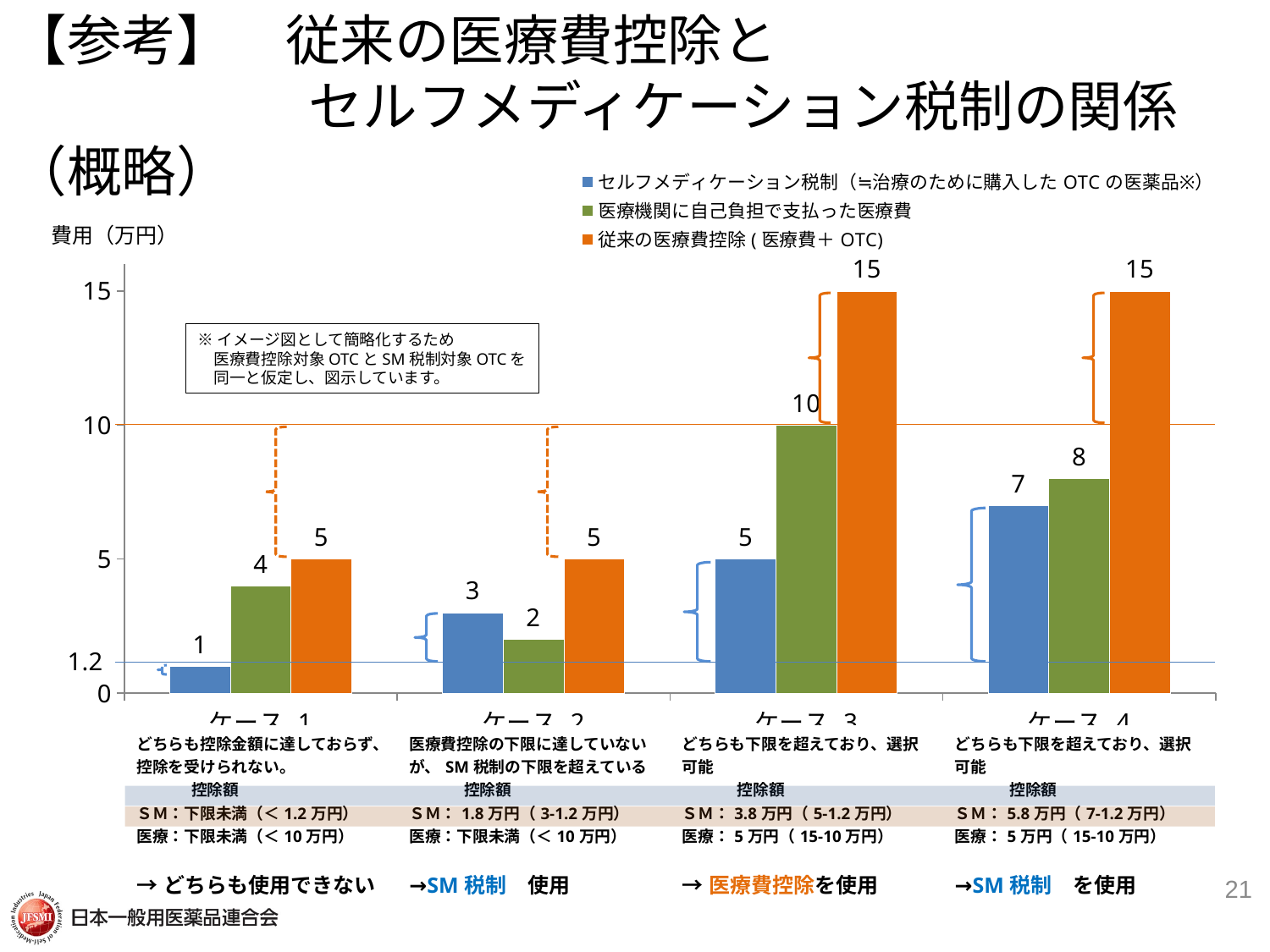
Which case has the lowest value for セルフメディケーション税制? ケース1 What is the unit shown on the y axis label? 万円 For ケース2, which is larger: セルフメディケーション税制 or 医療機関に自己負担で支払った医療費? セルフメディケーション税制 Does the value of セルフメディケーション税制 rise or fall from ケース1 to ケース4? rise Which case has the highest value for 医療機関に自己負担で支払った医療費? ケース3 What is the value of セルフメディケーション税制 for ケース4? 7 What is the difference between 従来の医療費控除 and セルフメディケーション税制 for ケース3? 10 How many categories (cases) are shown on the x axis? 4 How many series does the legend list? 3 What is the value of 従来の医療費控除 (医療費＋OTC) for ケース3? 15 What is the value of 医療機関に自己負担で支払った医療費 for ケース2? 2 What type of chart is shown on the slide? bar chart